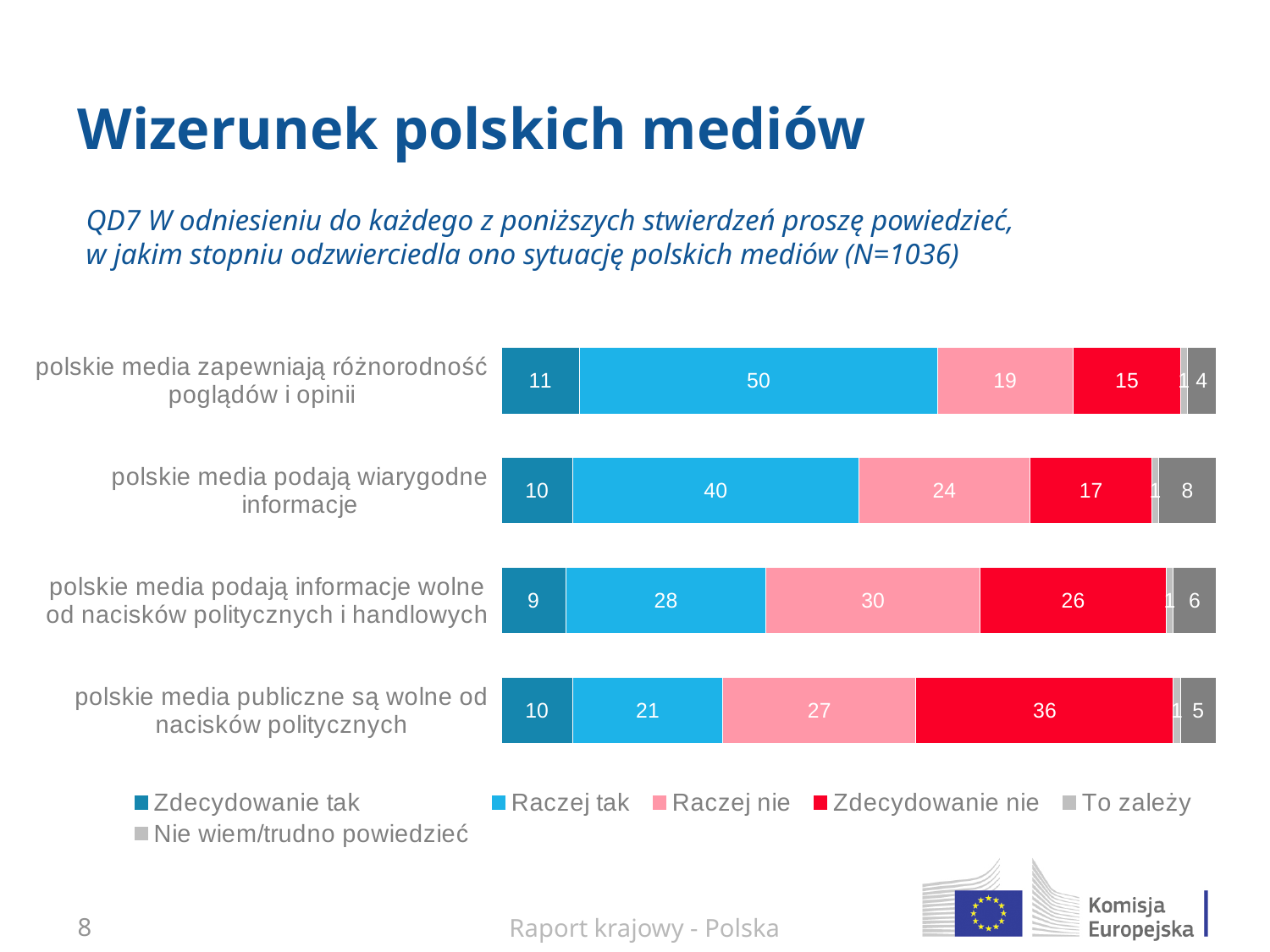
How many series does the legend list? 6 How many statements (categories) are plotted in the chart? 4 What is the value for "Raczej tak" for the statement "polskie media zapewniają różnorodność poglądów i opinii"? 50 What type of chart is shown on the slide? Stacked bar chart What is the difference between the "Raczej tak" values for "polskie media zapewniają różnorodność poglądów i opinii" and "polskie media podają wiarygodne informacje"? 10 For the statement "polskie media podają informacje wolne od nacisków politycznych i handlowych", which is larger: "Raczej tak" or "Raczej nie"? Raczej nie Which statement has the highest value for "Zdecydowanie nie"? polskie media publiczne są wolne od nacisków politycznych What is the value for "Nie wiem/trudno powiedzieć" for the statement "polskie media podają wiarygodne informacje"? 8 What is the value for "Zdecydowanie nie" for the statement "polskie media publiczne są wolne od nacisków politycznych"? 36 Which statement has the lowest value for "Raczej tak"? polskie media publiczne są wolne od nacisków politycznych What is the total of the "Zdecydowanie tak" and "Raczej tak" values for "polskie media podają wiarygodne informacje"? 50 Which legend entry is shown in the darkest blue colour? Zdecydowanie tak